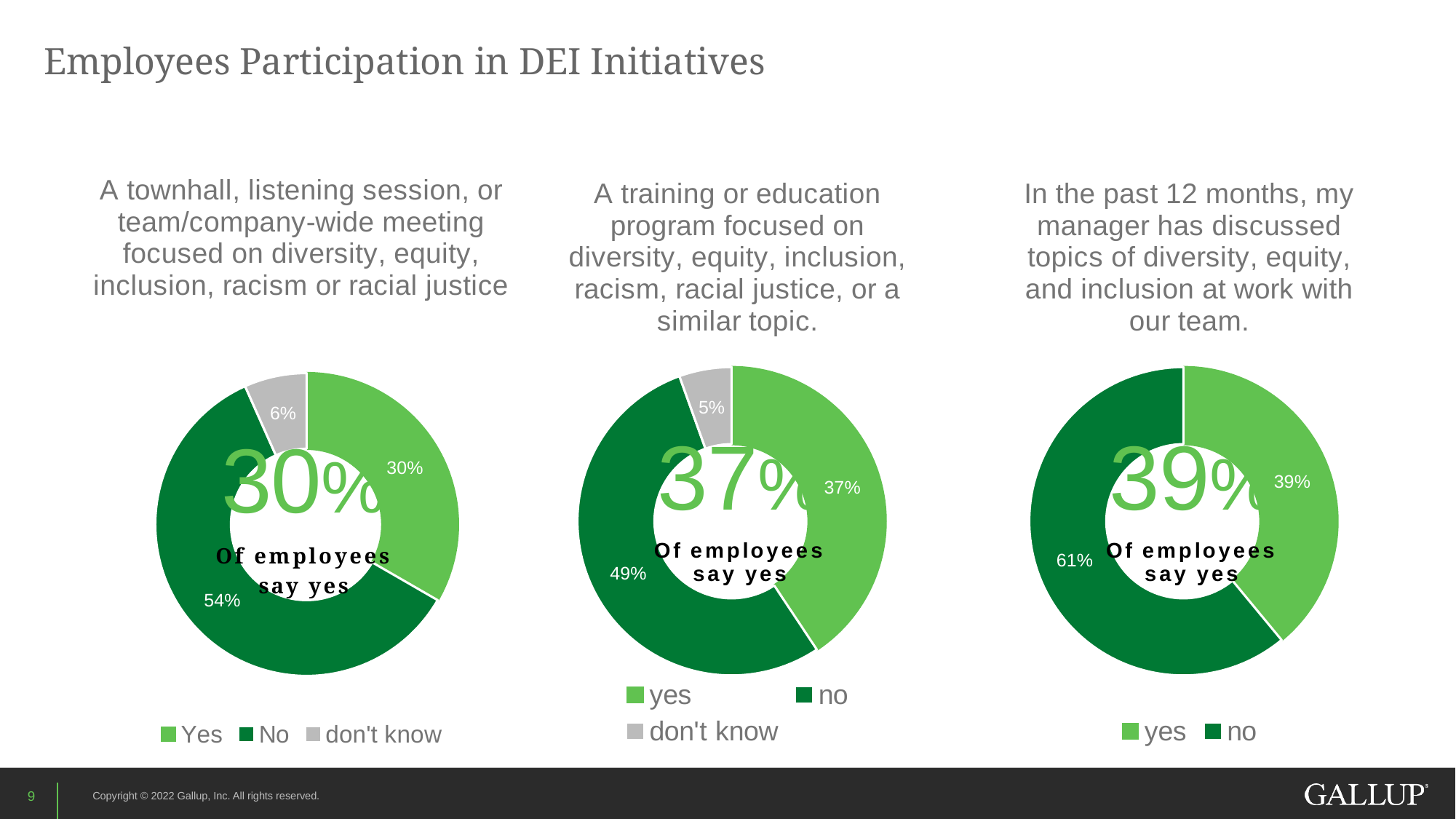
How many slices does the middle chart (training or education program) have? 3 In the middle chart (training or education program), what percentage of employees say don't know? 5% What kind of chart is used on this slide? Doughnut chart How many series does the legend of the right chart (manager has discussed DEI topics in the past 12 months) list? 2 In the left chart (townhall, listening session, or team/company-wide meeting), what percentage of employees say No? 54% In the middle chart (training or education program), which is larger: the yes share or the no share? no In the left chart (townhall, listening session, or team/company-wide meeting), what percentage of employees say Yes? 30% What colour represents the don't know response in the left chart (townhall, listening session, or team/company-wide meeting)? Grey In the middle chart (training or education program), which response has the largest share? no In the left chart (townhall, listening session, or team/company-wide meeting), which response has the smallest share? don't know In the right chart (manager has discussed DEI topics in the past 12 months), what is the difference between the no and yes percentages? 22% In the right chart (manager has discussed DEI topics in the past 12 months), what percentage of employees say no? 61%